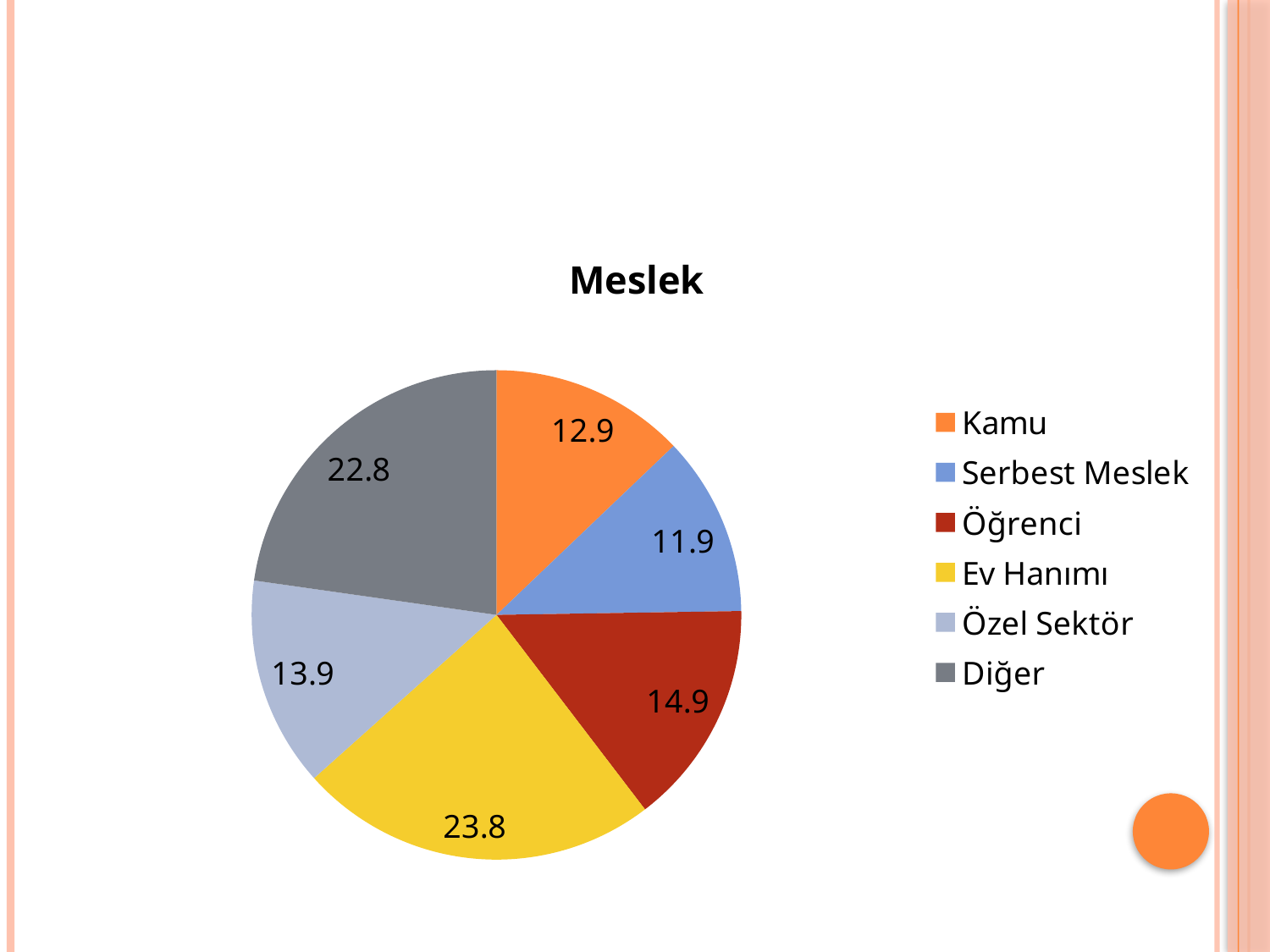
What is the difference between the values for Ev Hanımı and Diğer? 1.0 What is the value for Öğrenci? 14.9 Which category has the smallest slice? Serbest Meslek Which category has the largest slice? Ev Hanımı Which is larger, the value for Öğrenci or the value for Özel Sektör? Öğrenci How many categories does the pie chart have? 6 What type of chart is shown on the slide? pie chart What is the value for Ev Hanımı? 23.8 What is the title of the chart? Meslek What colour is the Diğer slice? dark grey What is the value for Kamu? 12.9 What is the value for Özel Sektör? 13.9